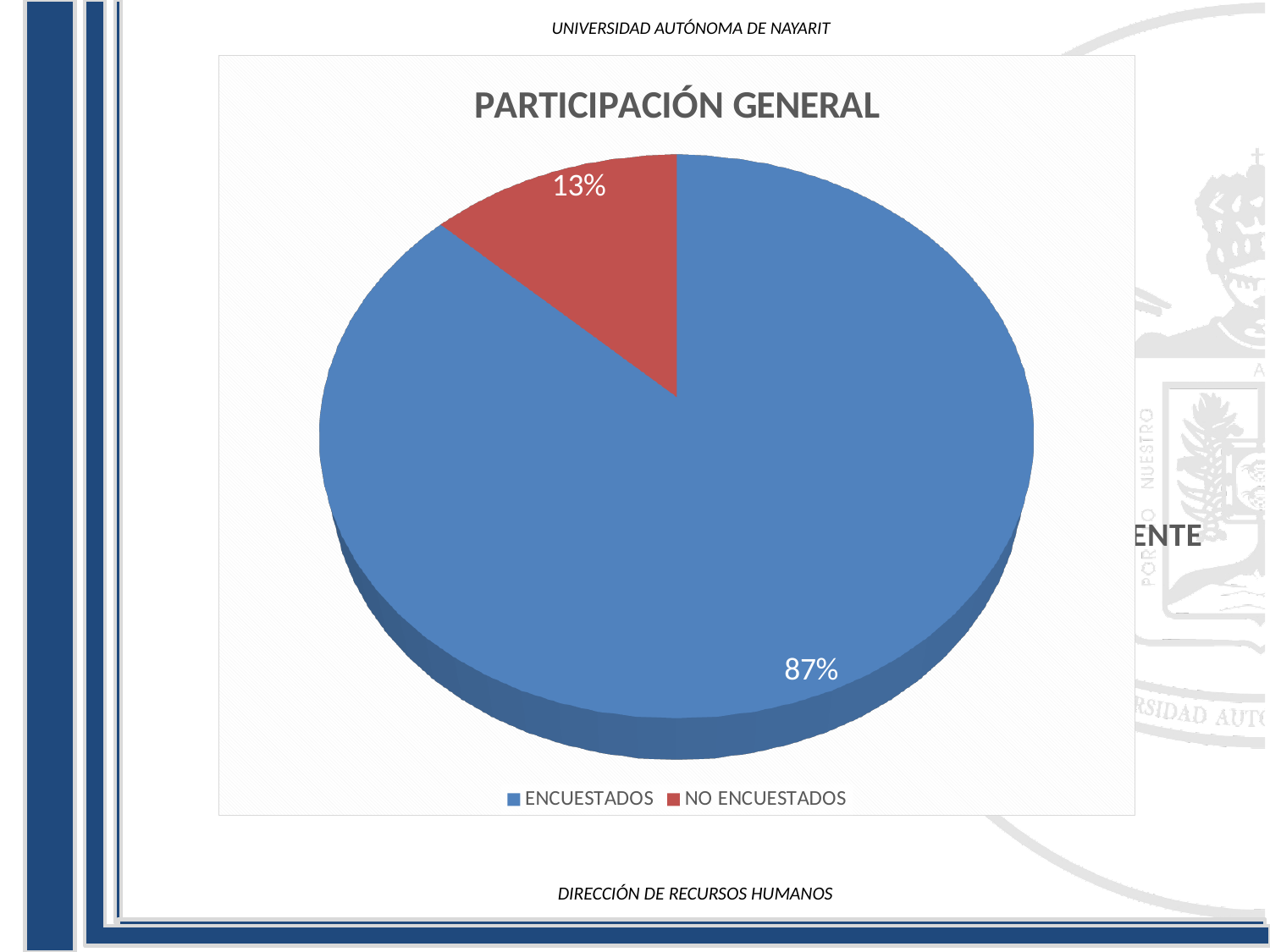
What percentage of the pie is NO ENCUESTADOS? 13% Which is larger, the share for ENCUESTADOS or the share for NO ENCUESTADOS? ENCUESTADOS What percentage of the pie is ENCUESTADOS? 87% How many categories does the pie chart show? 2 Which category has the largest share of the pie? ENCUESTADOS What colour is the NO ENCUESTADOS slice? red What is the title of the chart? PARTICIPACIÓN GENERAL What share of the pie does the ENCUESTADOS slice represent? 87% What kind of chart is shown on the slide? pie chart Which category has the smallest share of the pie? NO ENCUESTADOS What is the difference in percentage points between ENCUESTADOS and NO ENCUESTADOS? 74